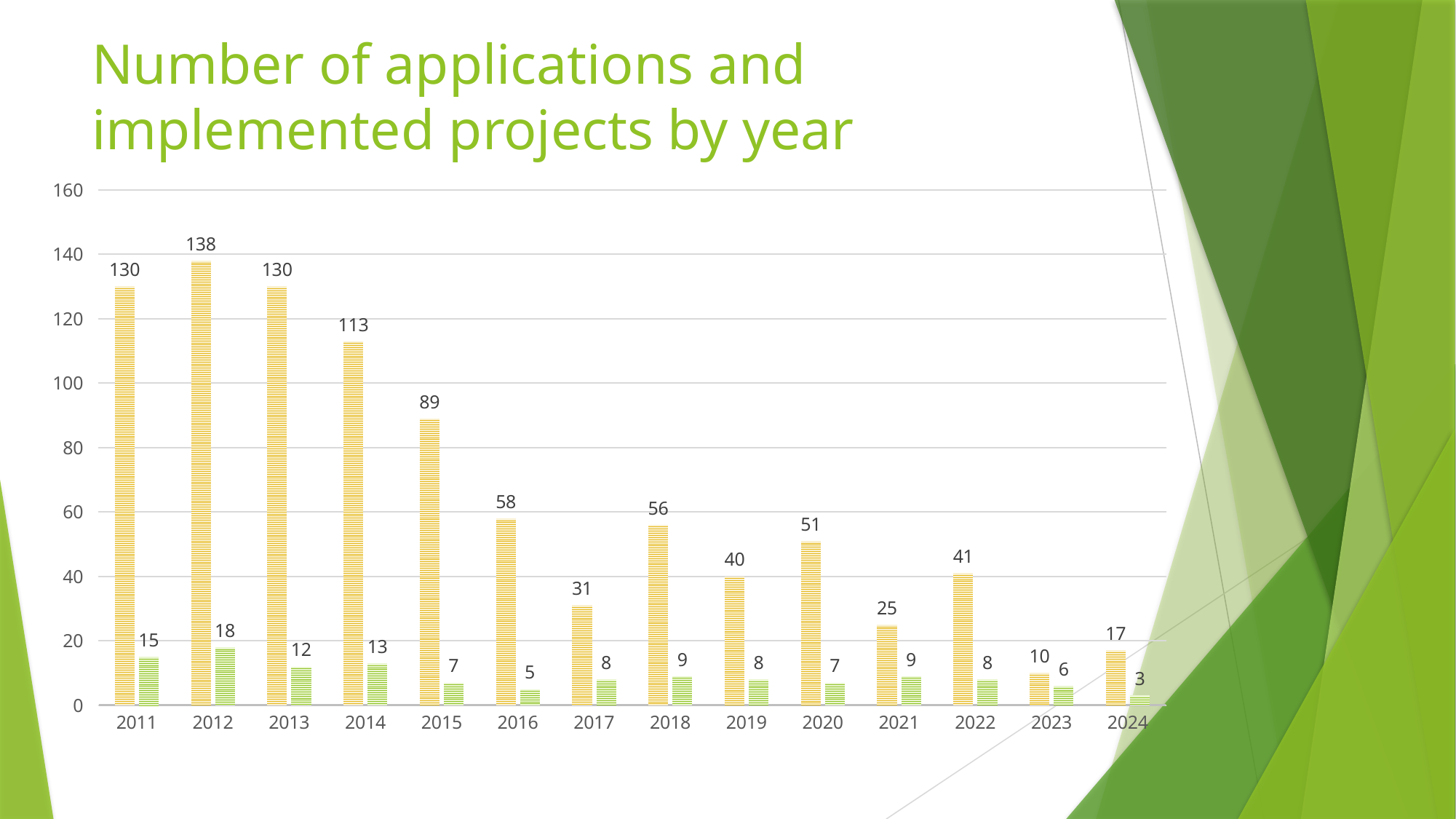
Do the orange bars rise or fall from 2011 to 2015? Fall Which year has the highest green bar? 2012 Which year has the larger orange bar, 2018 or 2020? 2018 What is the value of the green bar for 2012? 18 What is the value of the orange bar for 2014? 113 What kind of chart is shown on the slide? Bar chart Which year has the lowest orange bar? 2023 What is the title of the slide? Number of applications and implemented projects by year Which year has the highest orange bar? 2012 What is the difference between the orange bar and the green bar for 2011? 115 What is the value of the green bar for 2024? 3 How many years are shown on the x axis? 14